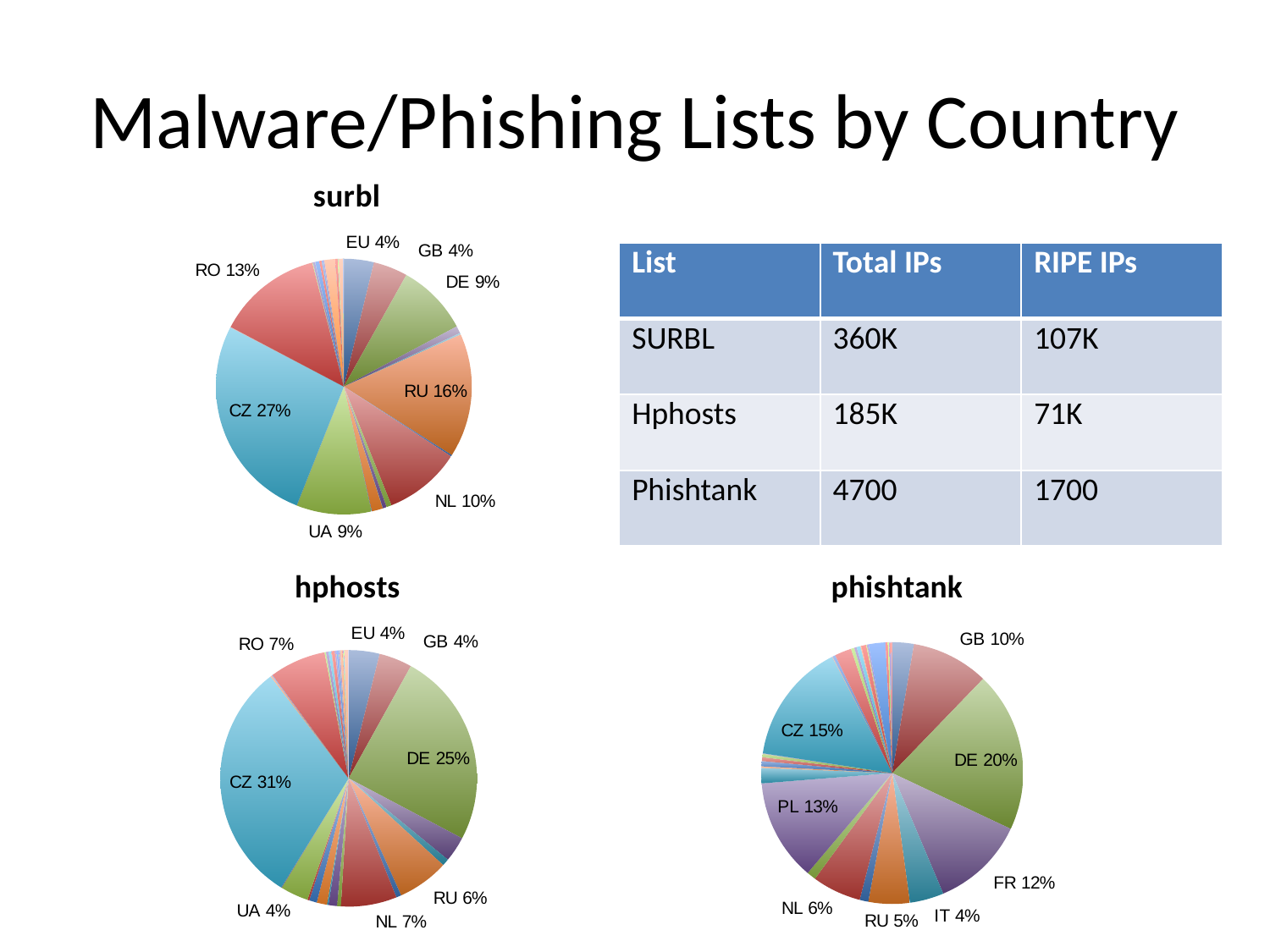
In the hphosts chart, what is the difference between the CZ share and the DE share? 6% In the phishtank chart, which labelled country has the largest share? DE In the surbl chart, what share of the pie does CZ have? 27% What kind of chart is the hphosts chart? Pie chart In the surbl chart, which is larger, the RO share or the DE share? RO In the hphosts chart, what share does DE have? 25% In the phishtank chart, what share does PL have? 13% In the hphosts chart, which labelled country has the largest share? CZ In the surbl chart, which labelled country has the largest share? CZ In the phishtank chart, which labelled country has the smallest share? IT In the surbl chart, what is the difference between the RU share and the NL share? 6% In the phishtank chart, which is larger, the CZ share or the FR share? CZ